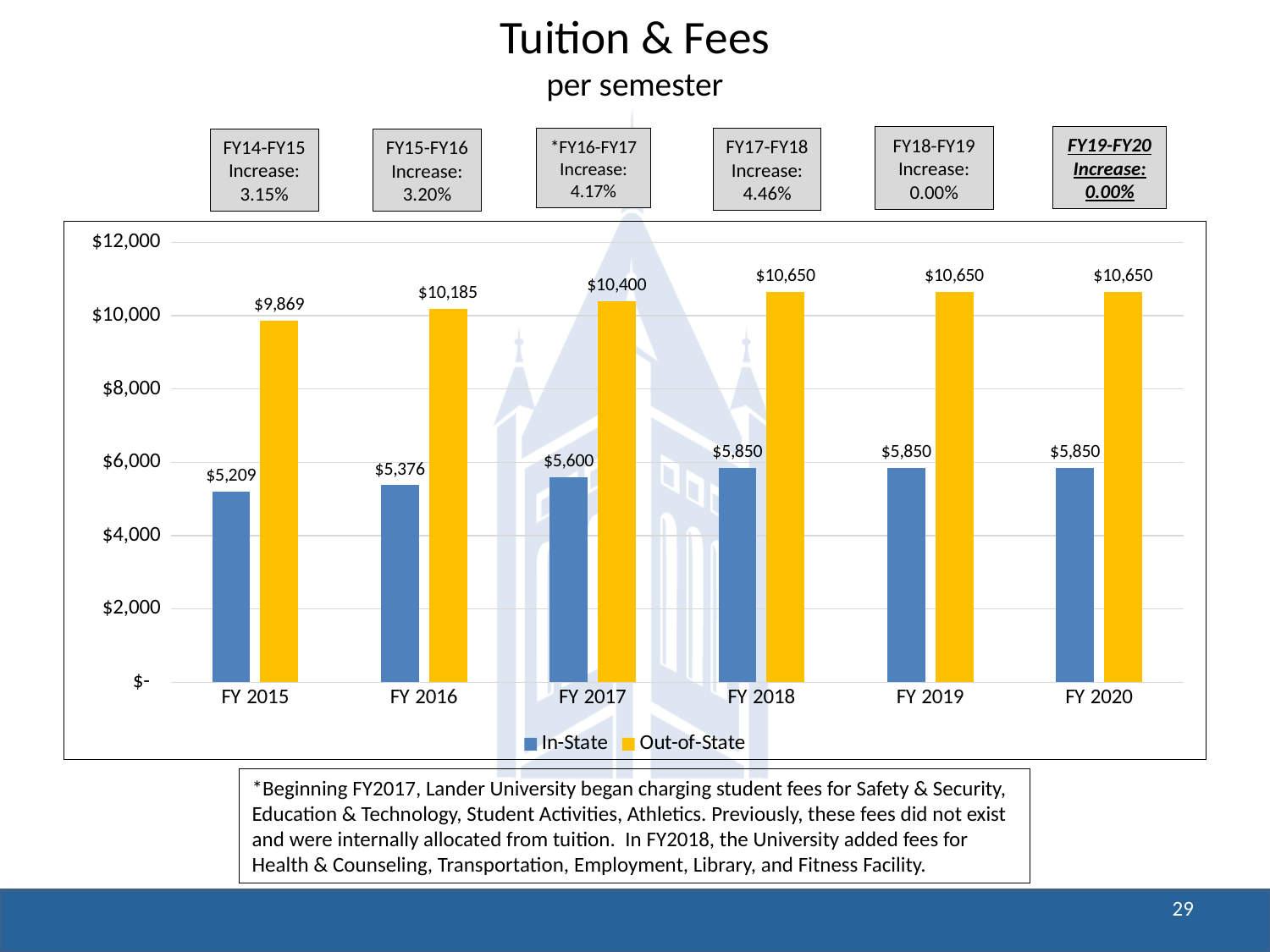
What kind of chart is shown on the slide? bar chart Which is larger, the Out-of-State value for FY 2015 or the Out-of-State value for FY 2016? FY 2016 What is the Out-of-State value for FY 2016? $10,185 What is the In-State tuition and fees value for FY 2015? $5,209 Which fiscal year has the lowest In-State value? FY 2015 How many fiscal years are shown on the x axis? 6 Do the Out-of-State values rise or fall from FY 2015 to FY 2018? rise What is the Out-of-State tuition and fees value for FY 2017? $10,400 How many series does the legend list? 2 What is the difference between the In-State values for FY 2016 and FY 2015? $167 What is the difference between the Out-of-State and In-State values for FY 2018? $4,800 Is the In-State value for FY 2017 greater or less than $6,000? less